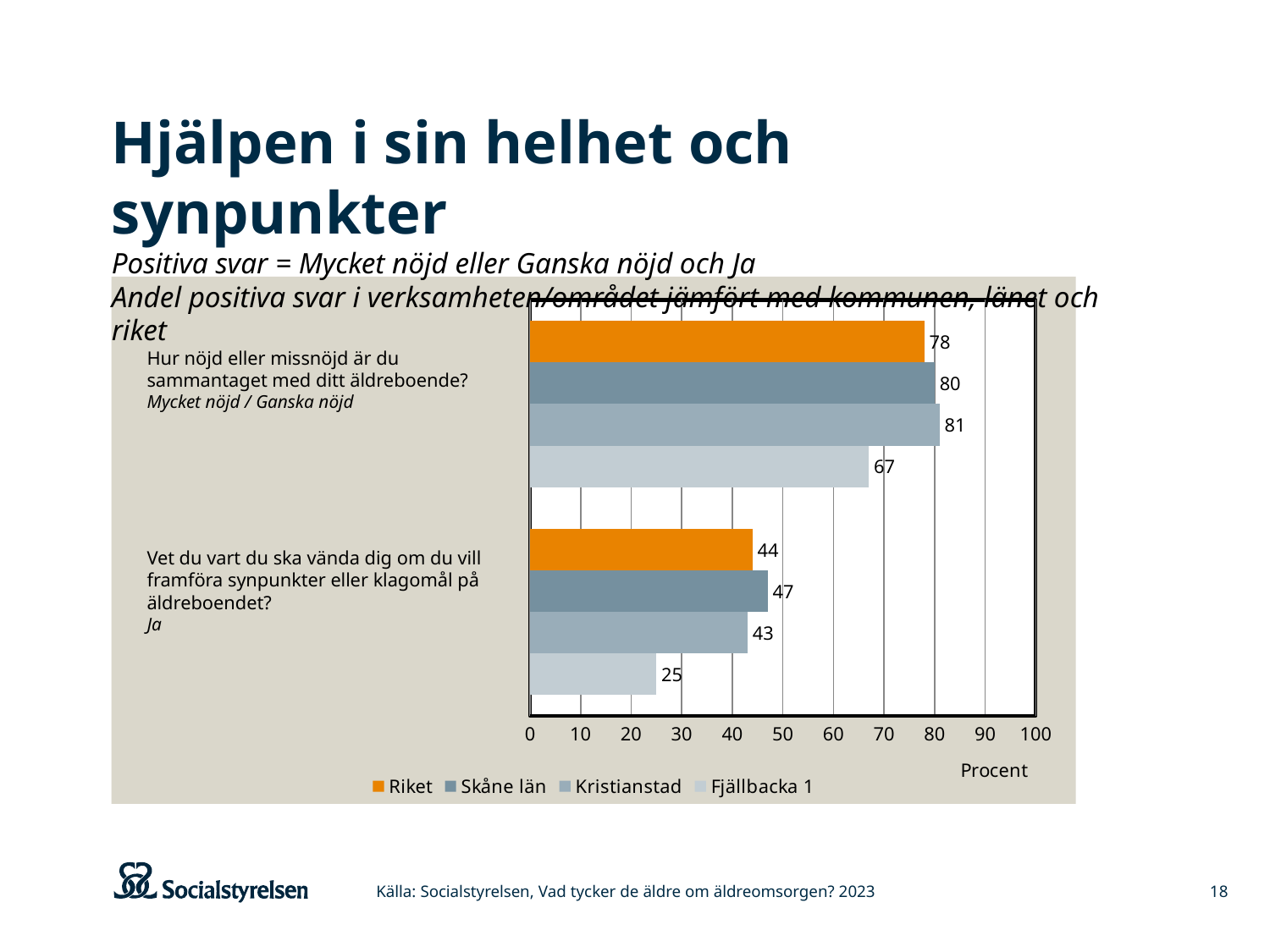
Which is larger on the question "Hur nöjd eller missnöjd är du sammantaget med ditt äldreboende?": Riket or Fjällbacka 1? Riket What kind of chart is shown on the slide? Bar chart How many series does the legend list? 4 What is the value for Fjällbacka 1 on the question "Hur nöjd eller missnöjd är du sammantaget med ditt äldreboende?"? 67 What is the value for Kristianstad on the question "Hur nöjd eller missnöjd är du sammantaget med ditt äldreboende?"? 81 How many question categories are shown on the chart? 2 Which series has the highest value on the question "Vet du vart du ska vända dig om du vill framföra synpunkter eller klagomål på äldreboendet?"? Skåne län What is the difference between Skåne län and Fjällbacka 1 on the question "Vet du vart du ska vända dig om du vill framföra synpunkter eller klagomål på äldreboendet?"? 22 What is the difference between Kristianstad and Fjällbacka 1 on the question "Hur nöjd eller missnöjd är du sammantaget med ditt äldreboende?"? 14 What is the value for Riket on the question "Vet du vart du ska vända dig om du vill framföra synpunkter eller klagomål på äldreboendet?"? 44 Which series has the lowest value on the question "Vet du vart du ska vända dig om du vill framföra synpunkter eller klagomål på äldreboendet?"? Fjällbacka 1 What is the label on the horizontal axis of the chart? Procent